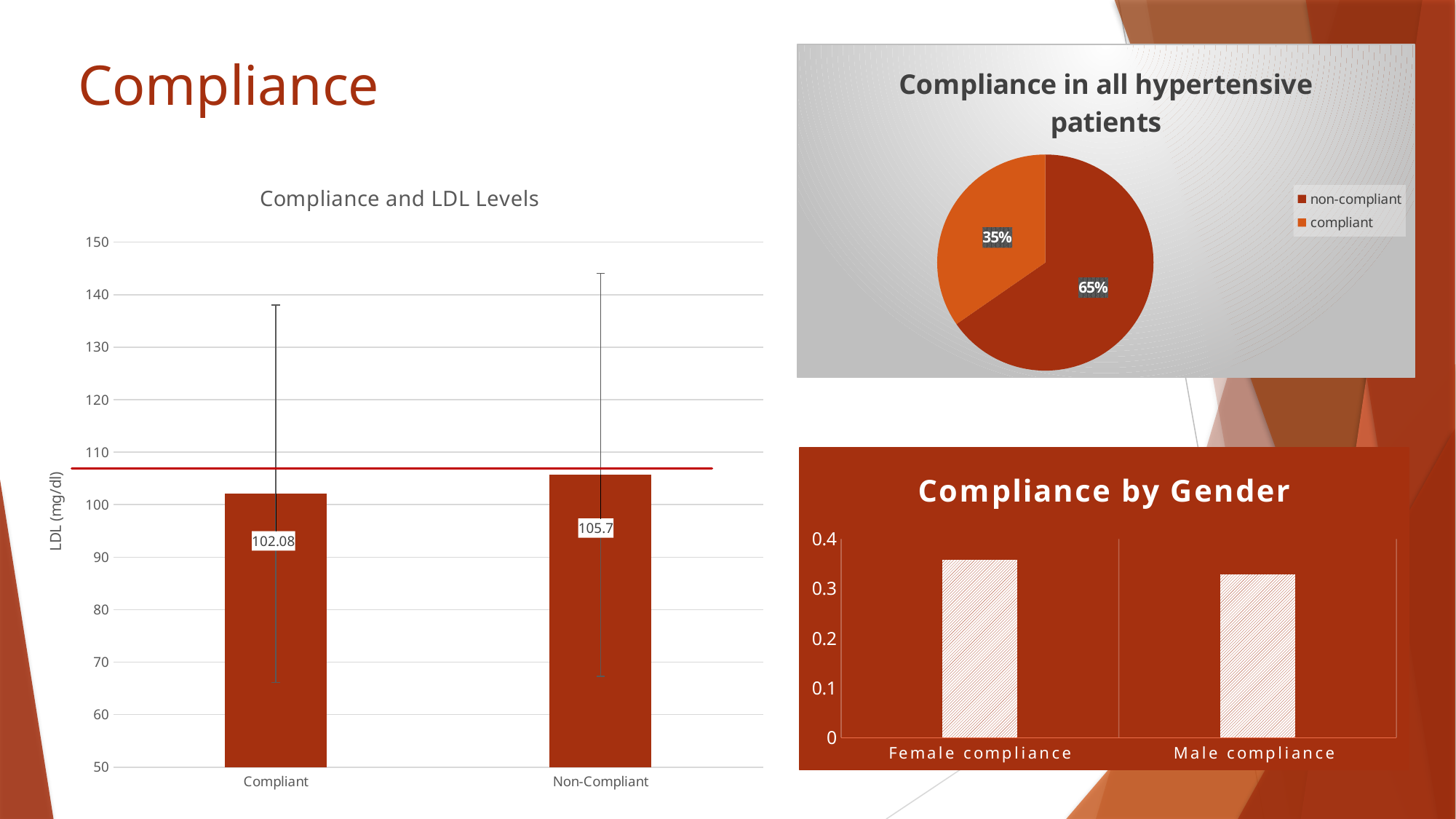
In the 'Compliance in all hypertensive patients' chart, what share of patients are compliant? 35% In the 'Compliance and LDL Levels' chart, what is the label on the vertical axis? LDL (mg/dl) In the 'Compliance and LDL Levels' chart, which group has the higher LDL value? Non-Compliant In the 'Compliance in all hypertensive patients' chart, what share of patients are non-compliant? 65% In the 'Compliance by Gender' chart, which category has the higher value? Female compliance In the 'Compliance and LDL Levels' chart, what is the difference between the Non-Compliant and Compliant LDL values? 3.62 How many entries does the legend of the 'Compliance in all hypertensive patients' chart list? 2 In the 'Compliance and LDL Levels' chart, what is the LDL value for the Compliant group? 102.08 What kind of chart is 'Compliance and LDL Levels'? Bar chart In the 'Compliance and LDL Levels' chart, what is the LDL value for the Non-Compliant group? 105.7 What kind of chart is 'Compliance in all hypertensive patients'? Pie chart In the 'Compliance by Gender' chart, is the value for Female compliance greater or less than 0.3? greater